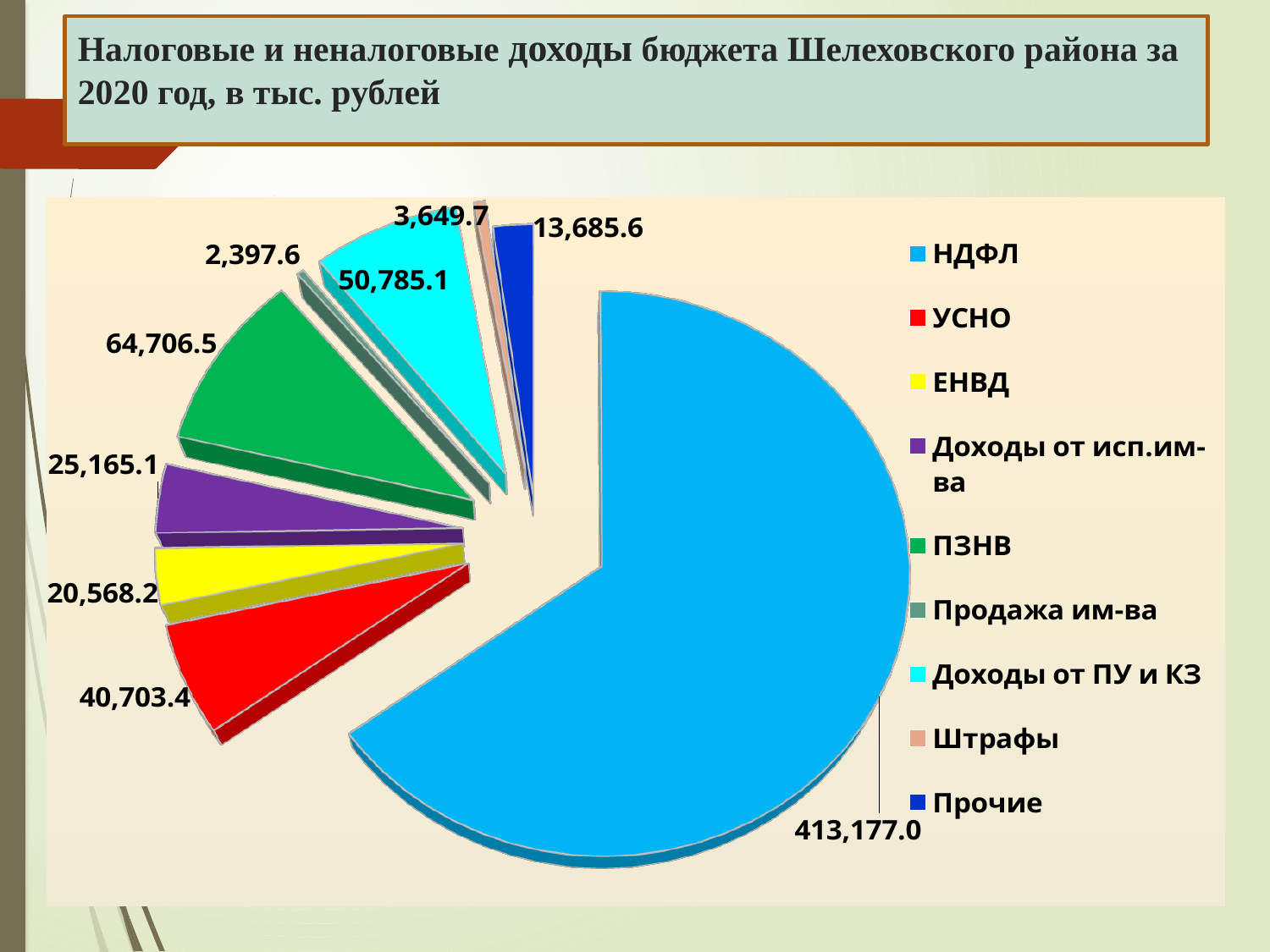
Which category has the largest value? НДФЛ How many categories does the pie chart have? 9 What is the value for ПЗНВ? 64,706.5 What is the value for Штрафы? 3,649.7 What colour is the slice for УСНО? Red What is the value for НДФЛ? 413,177.0 What is the difference between the values for Штрафы and Продажа им-ва? 1,252.1 Which is larger, the value for ЕНВД or the value for Доходы от исп.им-ва? Доходы от исп.им-ва What is the value for Доходы от ПУ и КЗ? 50,785.1 What type of chart is shown on the slide? Pie chart What is the difference between the values for ПЗНВ and УСНО? 24,003.1 Which category has the smallest value? Продажа им-ва